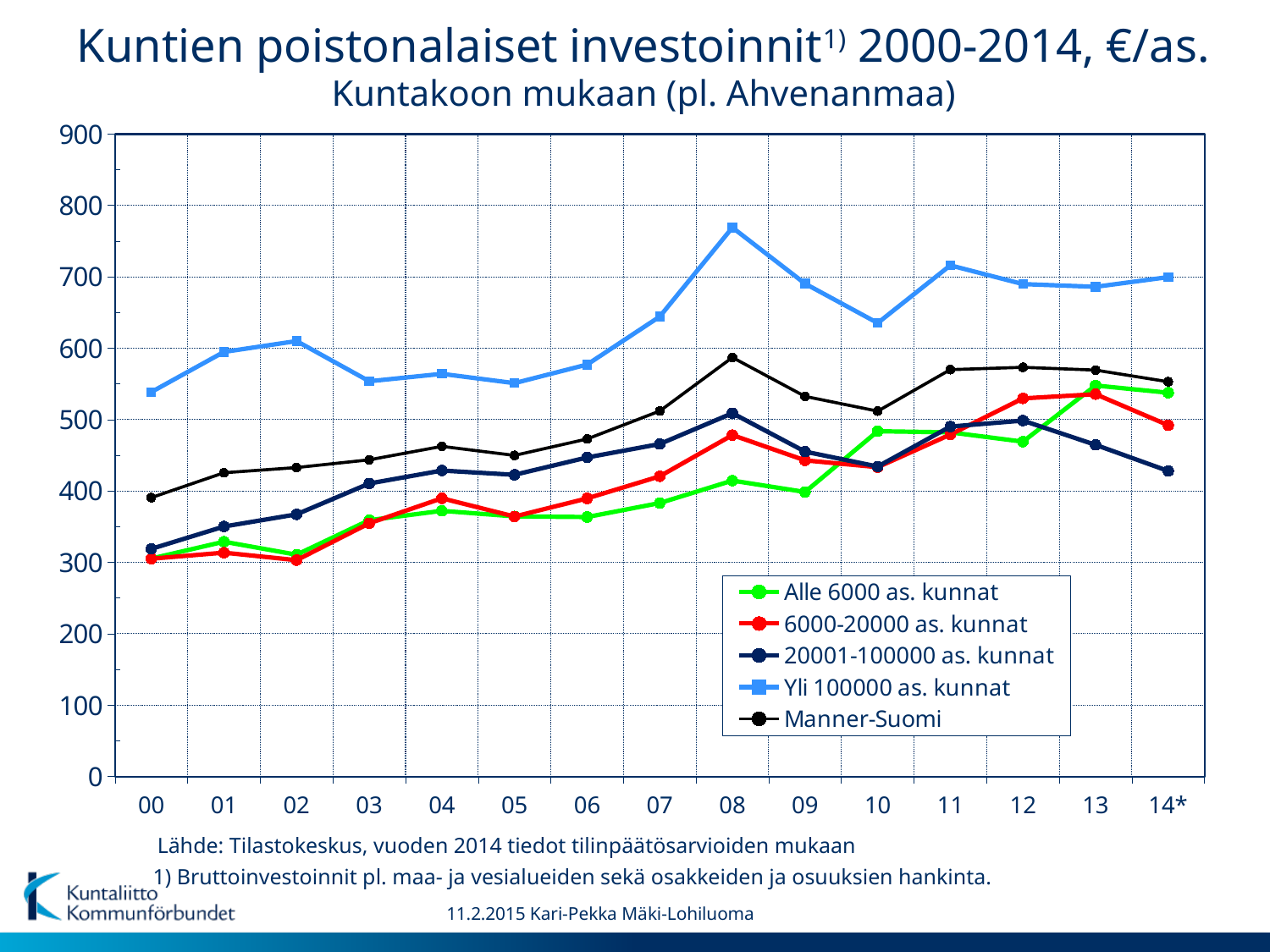
What colour is the Manner-Suomi line? black Does the Yli 100000 as. kunnat series rise or fall from 00 to 08? rise Is the value for Manner-Suomi in 08 greater or less than 500? greater Is the value for Yli 100000 as. kunnat in 08 greater or less than 700? greater How many years are plotted along the x axis? 15 Is the value for Alle 6000 as. kunnat in 00 greater or less than 400? less In 13, which is higher: Alle 6000 as. kunnat or 20001-100000 as. kunnat? Alle 6000 as. kunnat In which year does the Yli 100000 as. kunnat series reach its highest value? 08 How many series does the legend list? 5 Which series has the highest value in 08? Yli 100000 as. kunnat What kind of chart is shown on the slide? line chart Which series has the lowest value in 14*? 20001-100000 as. kunnat